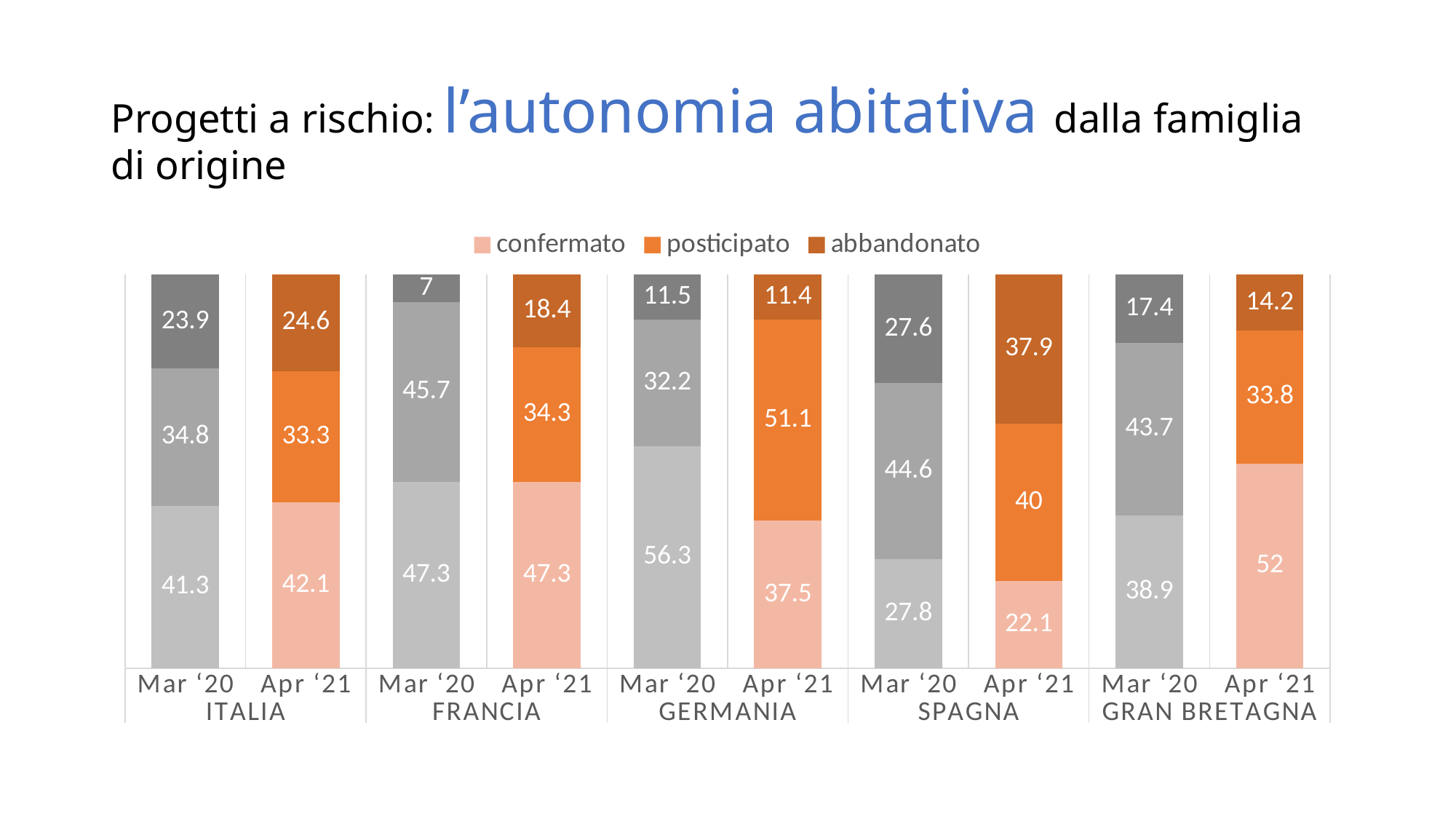
Which legend entry is shown in the darkest orange colour? abbandonato What is the total of the stacked bar for Italia in Apr '21? 100 Which bar has the highest 'confermato' value? Germania Mar '20 What is the difference between the 'abbandonato' values for Francia in Apr '21 and Mar '20? 11.4 Which is larger, the 'posticipato' value for Germania in Apr '21 or for Spagna in Apr '21? Germania Apr '21 How many series does the legend list? 3 Which bar has the lowest 'abbandonato' value? Francia Mar '20 What is the 'posticipato' value for Gran Bretagna in Mar '20? 43.7 How many bars are plotted in the chart? 10 What kind of chart is shown on the slide? stacked bar chart What is the 'confermato' value for Germania in Mar '20? 56.3 What is the 'abbandonato' value for Spagna in Apr '21? 37.9